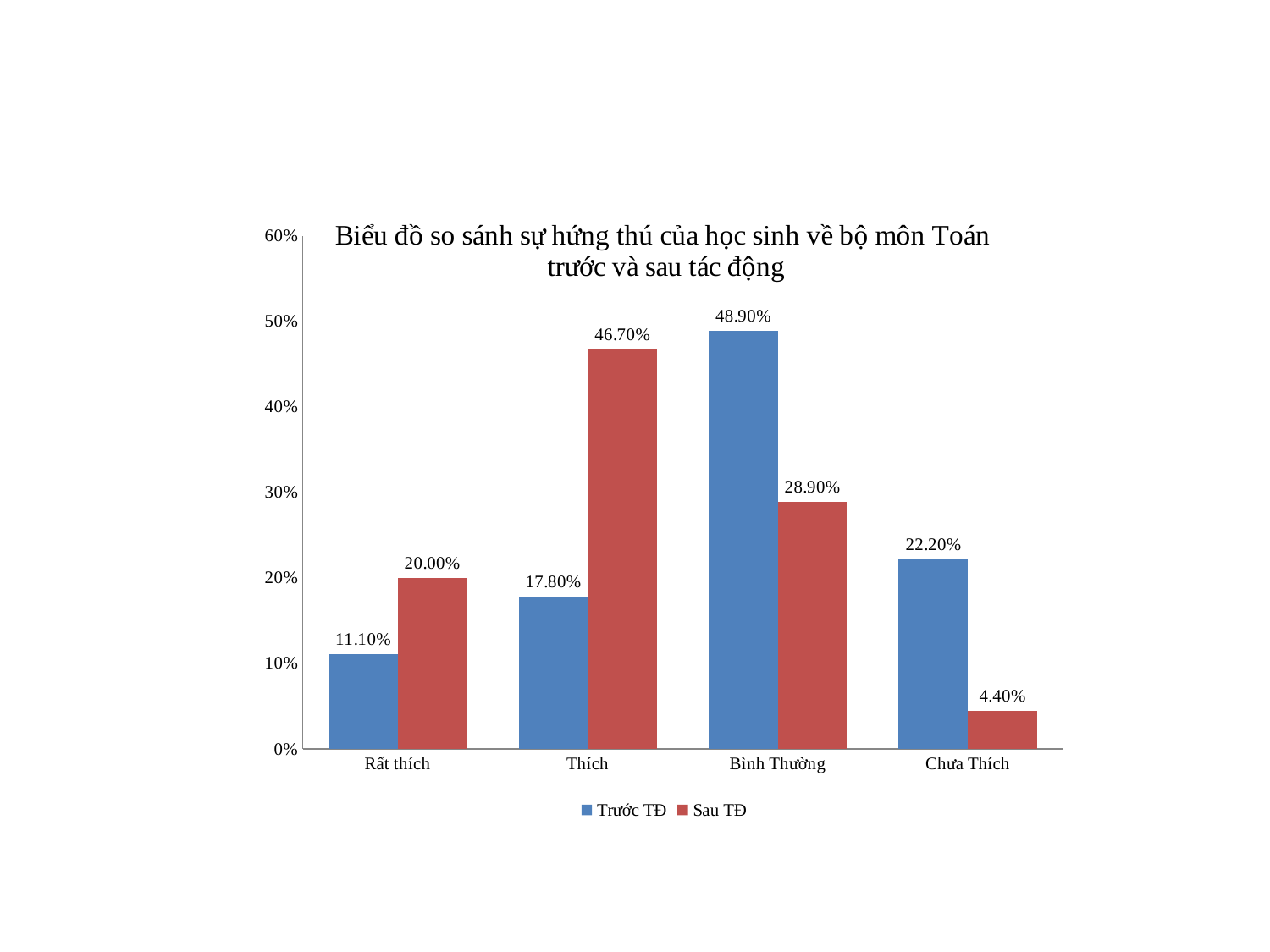
What is the value for Trước TĐ in the Rất thích category? 11.10% What is the value for Sau TĐ in the Thích category? 46.70% What is the difference between the Trước TĐ and Sau TĐ values in the Bình Thường category? 20.00% How many categories are shown on the x axis? 4 In the Thích category, which series has the larger value, Trước TĐ or Sau TĐ? Sau TĐ What kind of chart is shown on the slide? Bar chart How many series does the legend list? 2 What is the value for Sau TĐ in the Chưa Thích category? 4.40% Which category has the lowest value for Sau TĐ? Chưa Thích Which category has the highest value for Trước TĐ? Bình Thường Is the value for Trước TĐ in the Chưa Thích category greater or less than 20%? greater Which colour represents the Sau TĐ series? Red